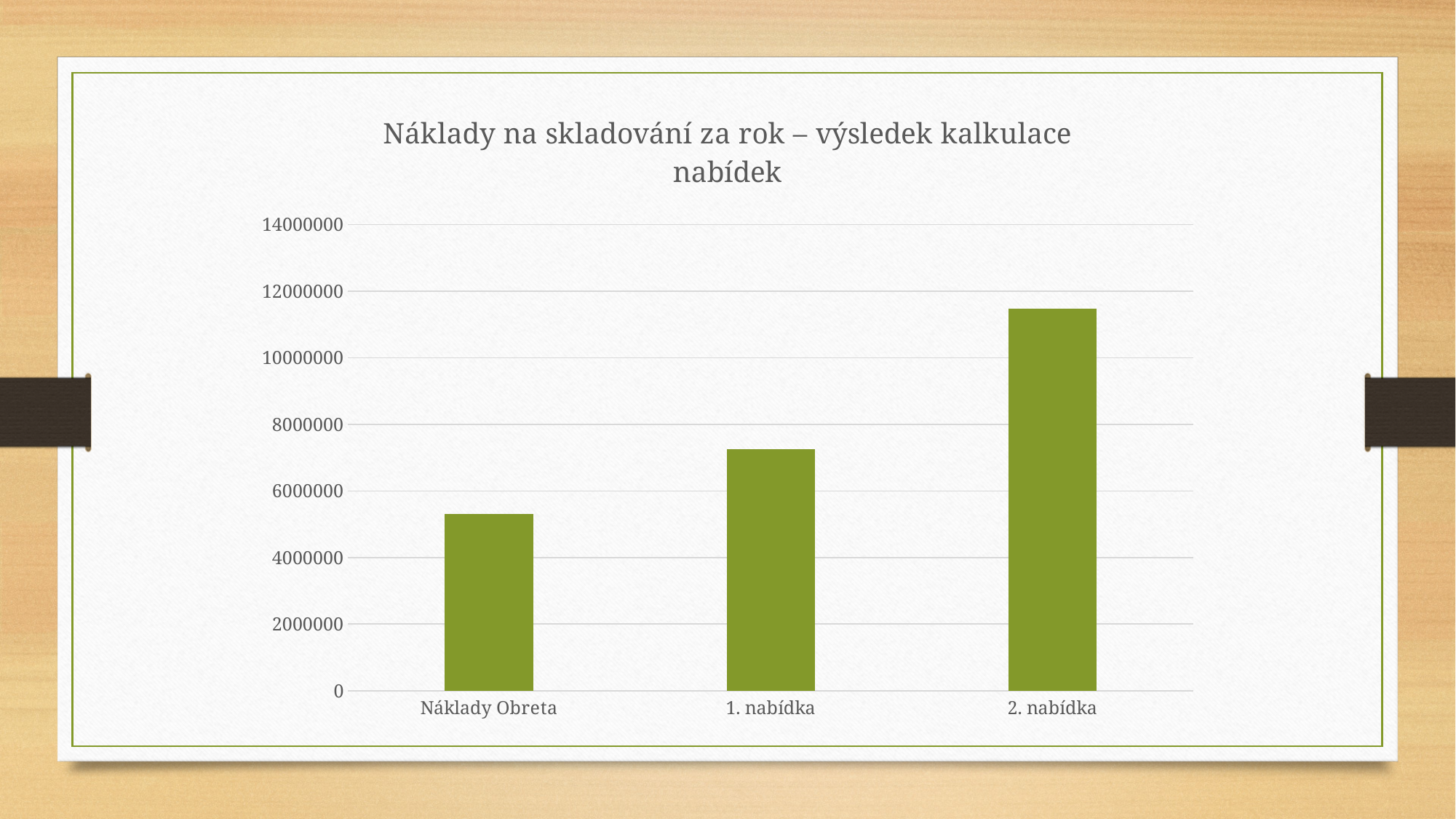
Is the value for 2. nabídka greater or less than 10000000? greater Which is larger, the value for 1. nabídka or the value for Náklady Obreta? 1. nabídka Which category has the lowest value? Náklady Obreta Is the value for 2. nabídka greater or less than 12000000? less Which is larger, the value for 2. nabídka or the value for 1. nabídka? 2. nabídka Do the values rise or fall from left to right along the x axis? rise Is the value for Náklady Obreta greater or less than 6000000? less How many categories are plotted on the x axis? 3 Which category has the highest value? 2. nabídka What is the title of the chart? Náklady na skladování za rok – výsledek kalkulace nabídek What kind of chart is shown on the slide? bar chart